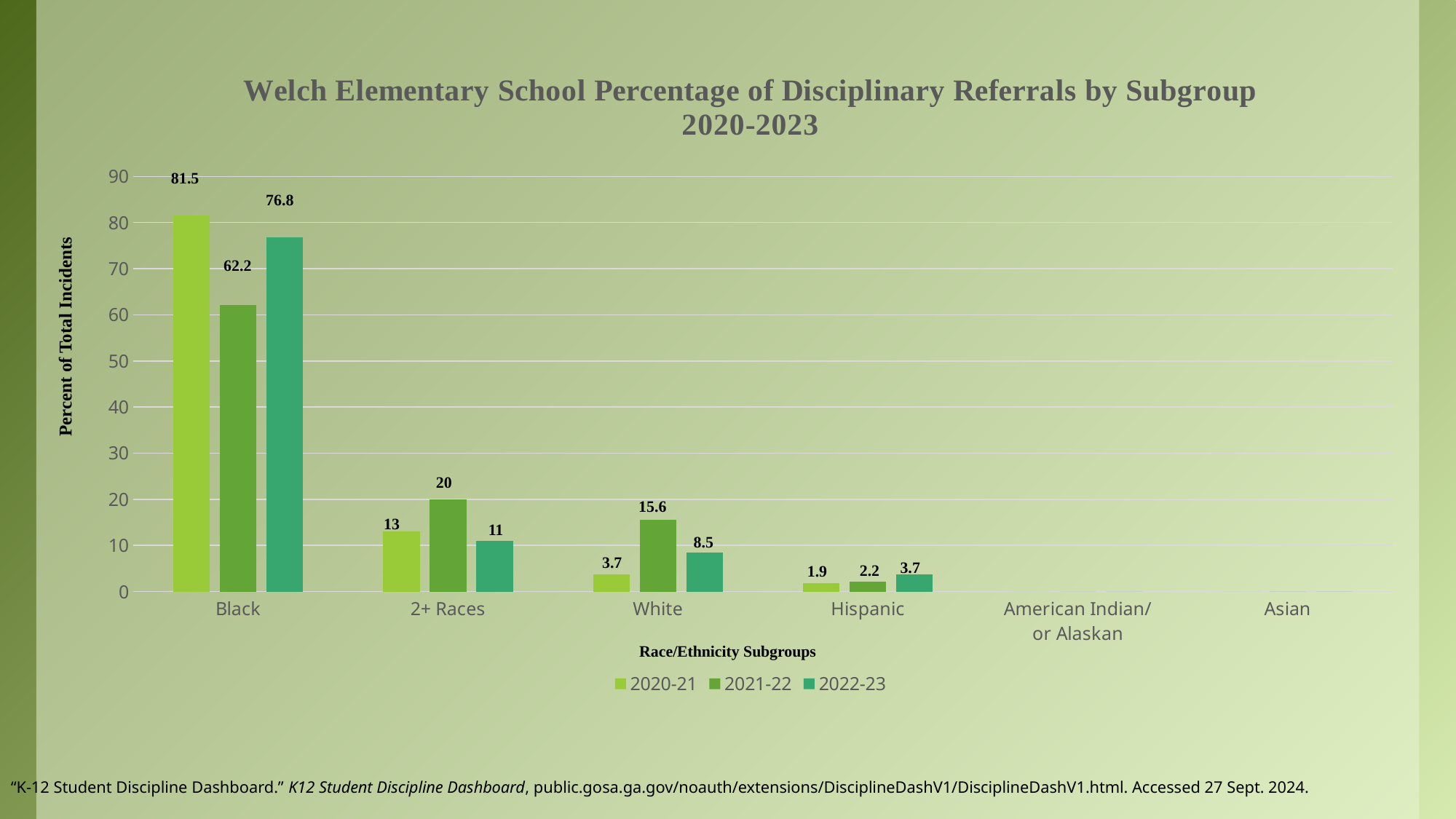
What is the label of the y axis? Percent of Total Incidents Which year has the lowest value for Black? 2021-22 What is the value for 2+ Races in 2021-22? 20 How many race/ethnicity subgroups are shown on the x axis? 6 Which is larger for White: the 2021-22 value or the 2020-21 value? 2021-22 What is the value for White in 2022-23? 8.5 What kind of chart is shown on the slide? Bar chart Which subgroup has the highest value in 2022-23? Black What is the difference between the 2020-21 and 2022-23 values for Black? 4.7 How many series does the legend list? 3 What is the value for Black in 2020-21? 81.5 What is the value for Hispanic in 2021-22? 2.2